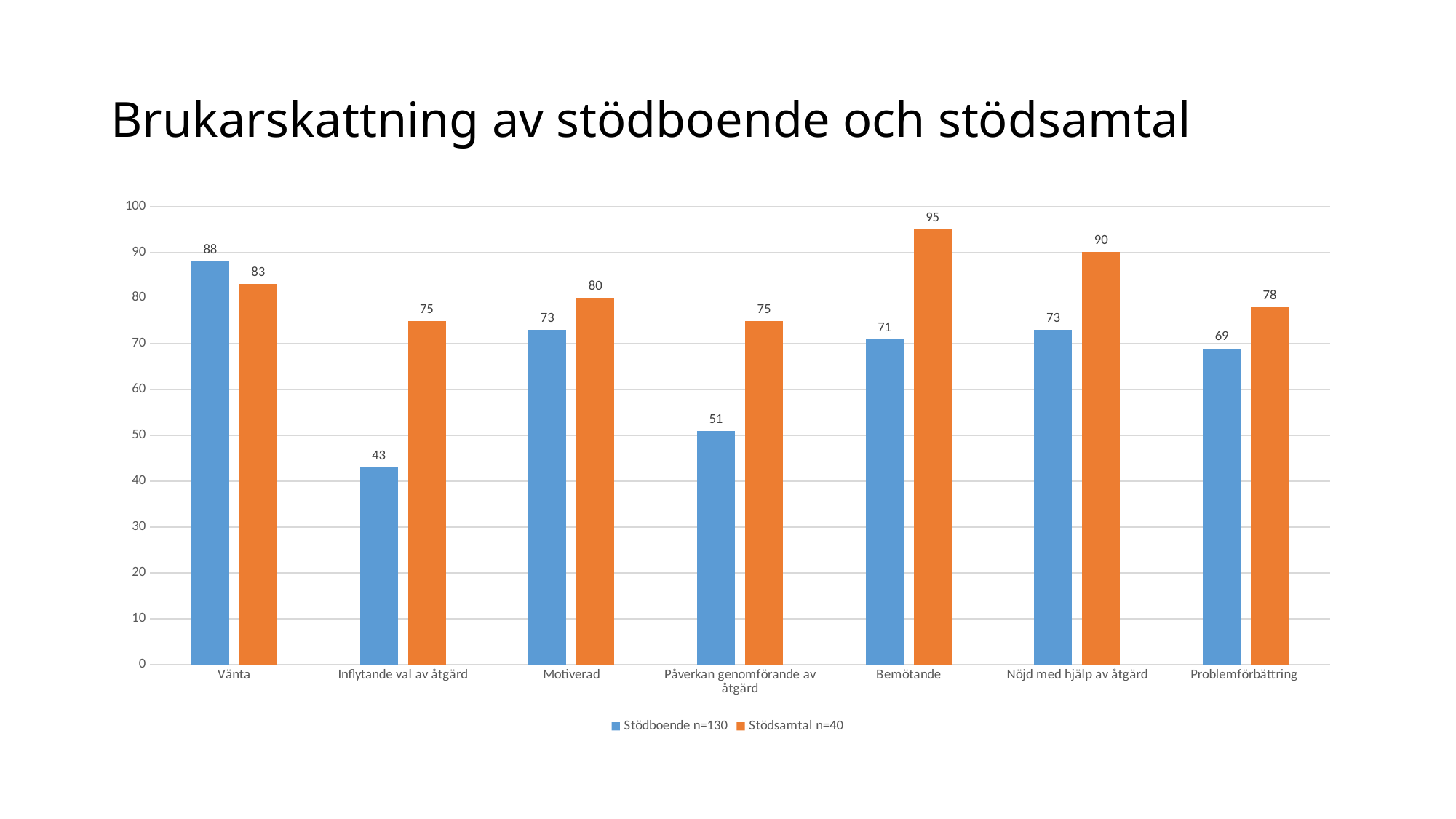
What is the value for Stödsamtal n=40 in the Bemötande category? 95 Which category has the lowest value for Stödboende n=130? Inflytande val av åtgärd Is the value for Stödboende n=130 in the Påverkan genomförande av åtgärd category greater or less than 60? less Which series has the larger value in the Vänta category, Stödboende n=130 or Stödsamtal n=40? Stödboende n=130 How many categories are shown on the x axis? 7 What colour are the bars for Stödsamtal n=40? orange What is the difference between Stödsamtal n=40 and Stödboende n=130 in the Inflytande val av åtgärd category? 32 Which category has the highest value for Stödsamtal n=40? Bemötande What is the value for Stödboende n=130 in the Vänta category? 88 How many series does the legend list? 2 What is the value for Stödboende n=130 in the Inflytande val av åtgärd category? 43 What kind of chart is shown on the slide? bar chart